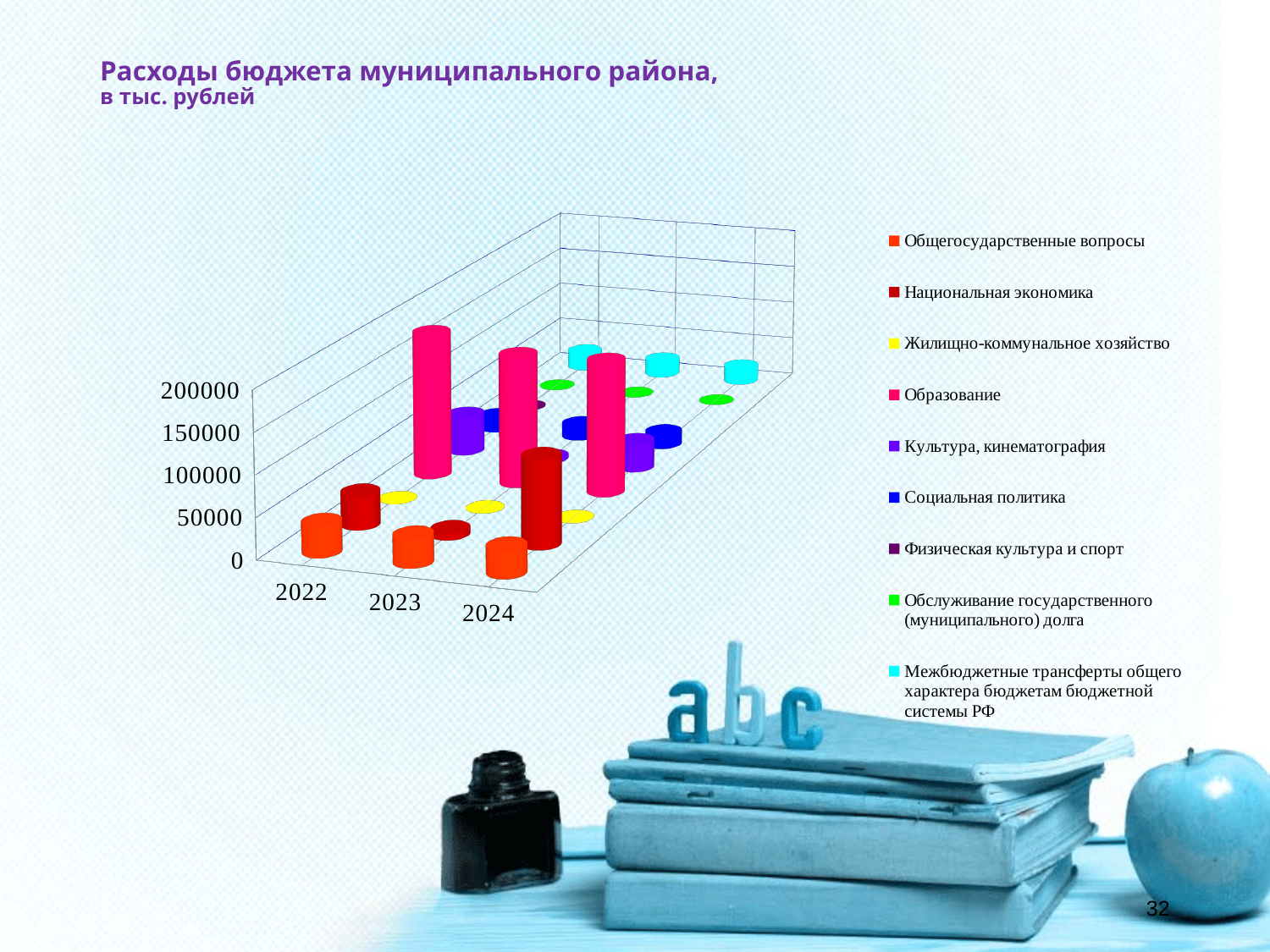
Which legend entry is shown in pink? Образование Is the value for Обслуживание государственного (муниципального) долга in 2024 greater or less than 50000? less What kind of chart is shown on the slide? bar chart Which is larger for Национальная экономика: the value in 2023 or the value in 2024? 2024 Is the value for Образование in 2022 greater or less than 100000? greater How many years are shown on the x axis of the chart? 3 What is the title of the chart on the slide? Расходы бюджета муниципального района, в тыс. рублей Which is larger in 2022: Образование or Общегосударственные вопросы? Образование How many series does the chart legend list? 9 Is the value for Национальная экономика in 2024 greater or less than 50000? greater Which expenditure category has the highest values in the chart? Образование